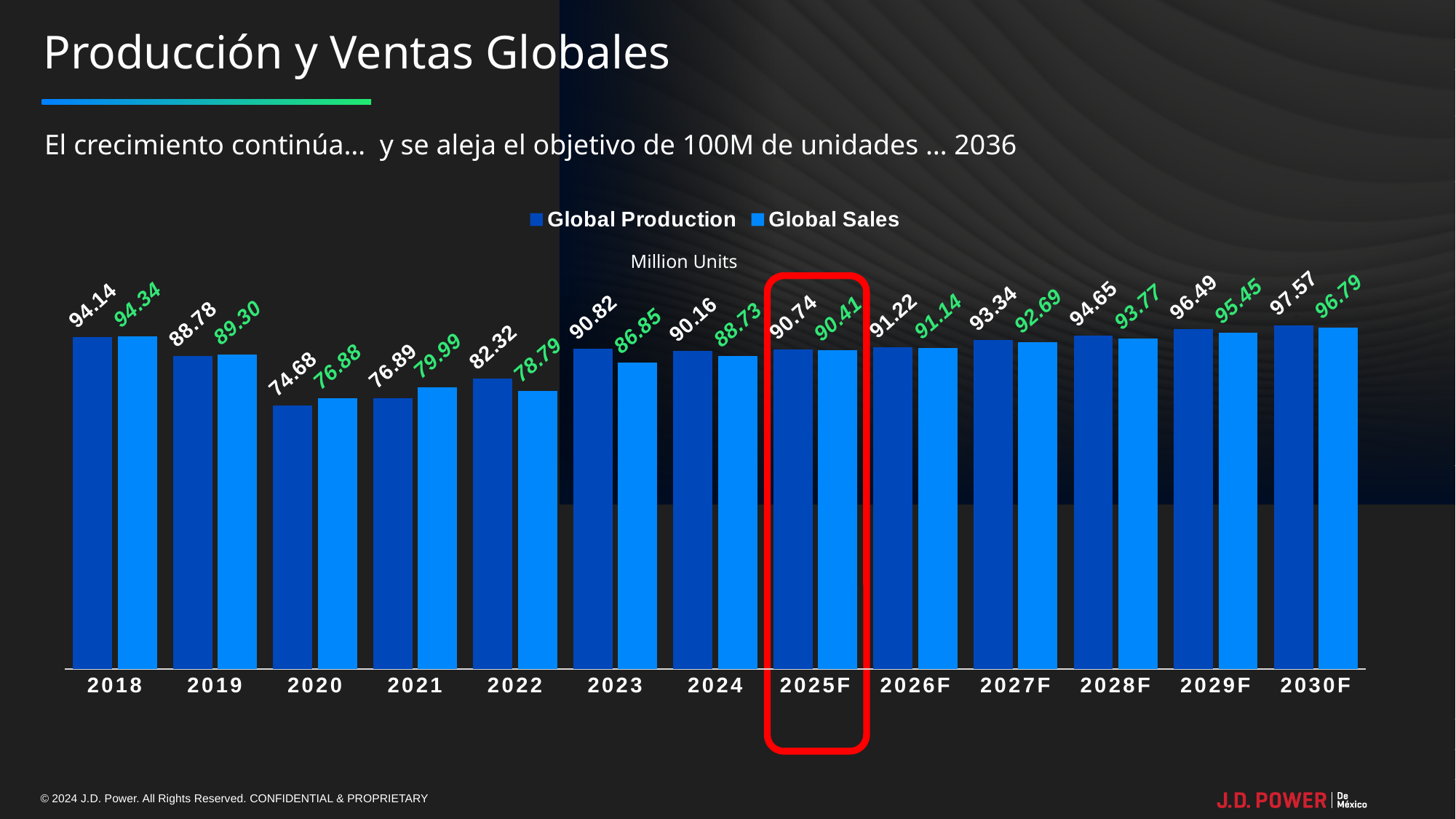
What is the Global Sales value for 2025F? 90.41 How many years are shown on the x axis? 13 What is the Global Sales value for 2018? 94.34 Which year has the lowest Global Production value? 2020 What is the Global Production value for 2020? 74.68 Which is larger in 2023, Global Production or Global Sales? Global Production What unit is stated below the legend of the chart? Million Units Which year has the highest Global Sales value? 2030F How many series does the legend list? 2 What is the difference between Global Production and Global Sales in 2022? 3.53 Do the Global Production values rise or fall from 2020 to 2030F? Rise What kind of chart is shown on the slide? Bar chart